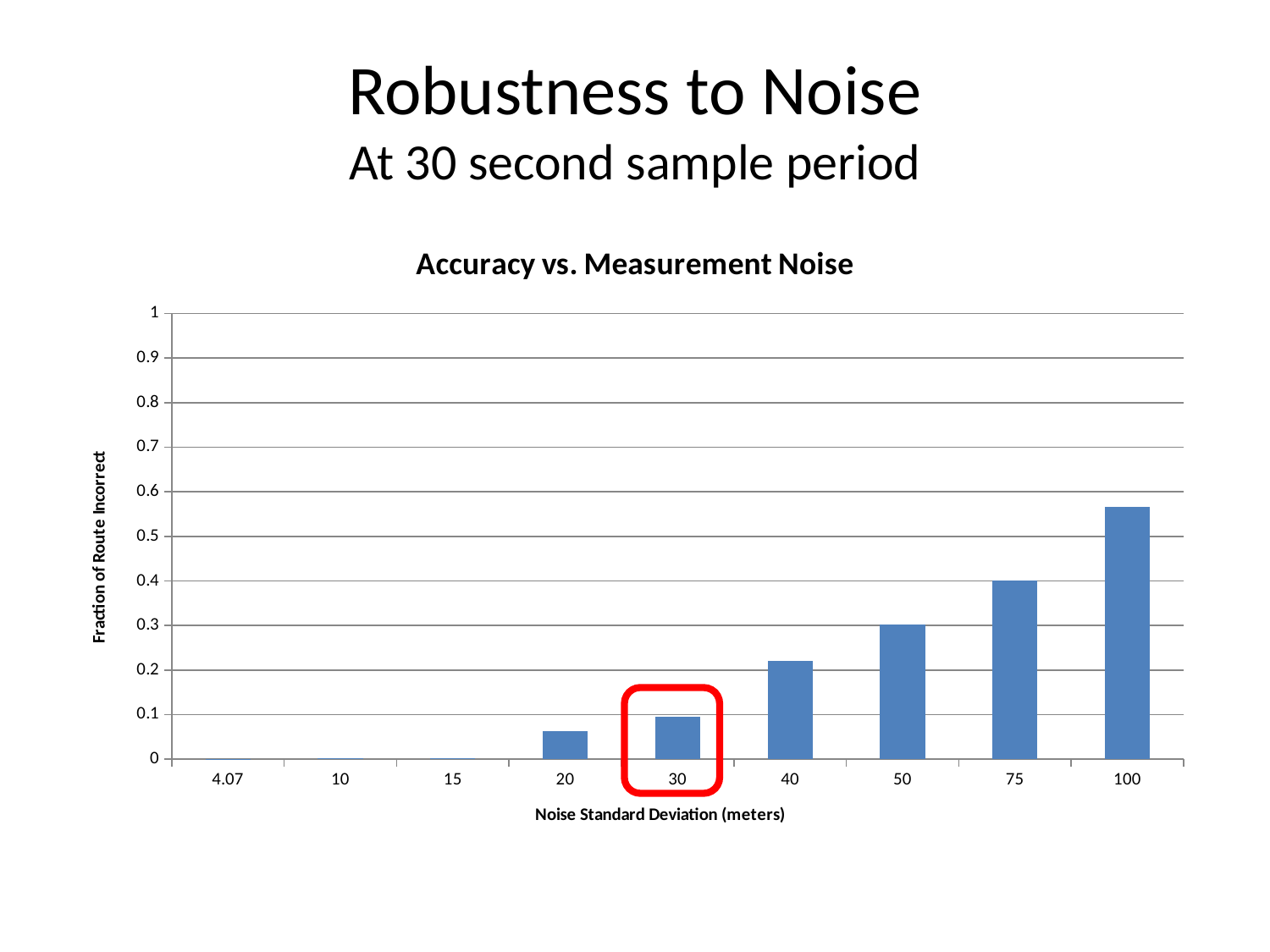
What is the label of the y axis? Fraction of Route Incorrect What type of chart is shown on the slide? bar chart Is the value for a noise standard deviation of 50 greater or less than 0.2? greater Which has a larger fraction of route incorrect, a noise standard deviation of 40 or 75? 75 What is the title of the chart? Accuracy vs. Measurement Noise Is the value for a noise standard deviation of 75 greater or less than 0.3? greater Is the value for a noise standard deviation of 100 greater or less than 0.5? greater Do the values rise or fall as the noise standard deviation increases along the x axis? rise Which noise standard deviation has the highest fraction of route incorrect? 100 How many noise standard deviation categories are shown on the x axis? 9